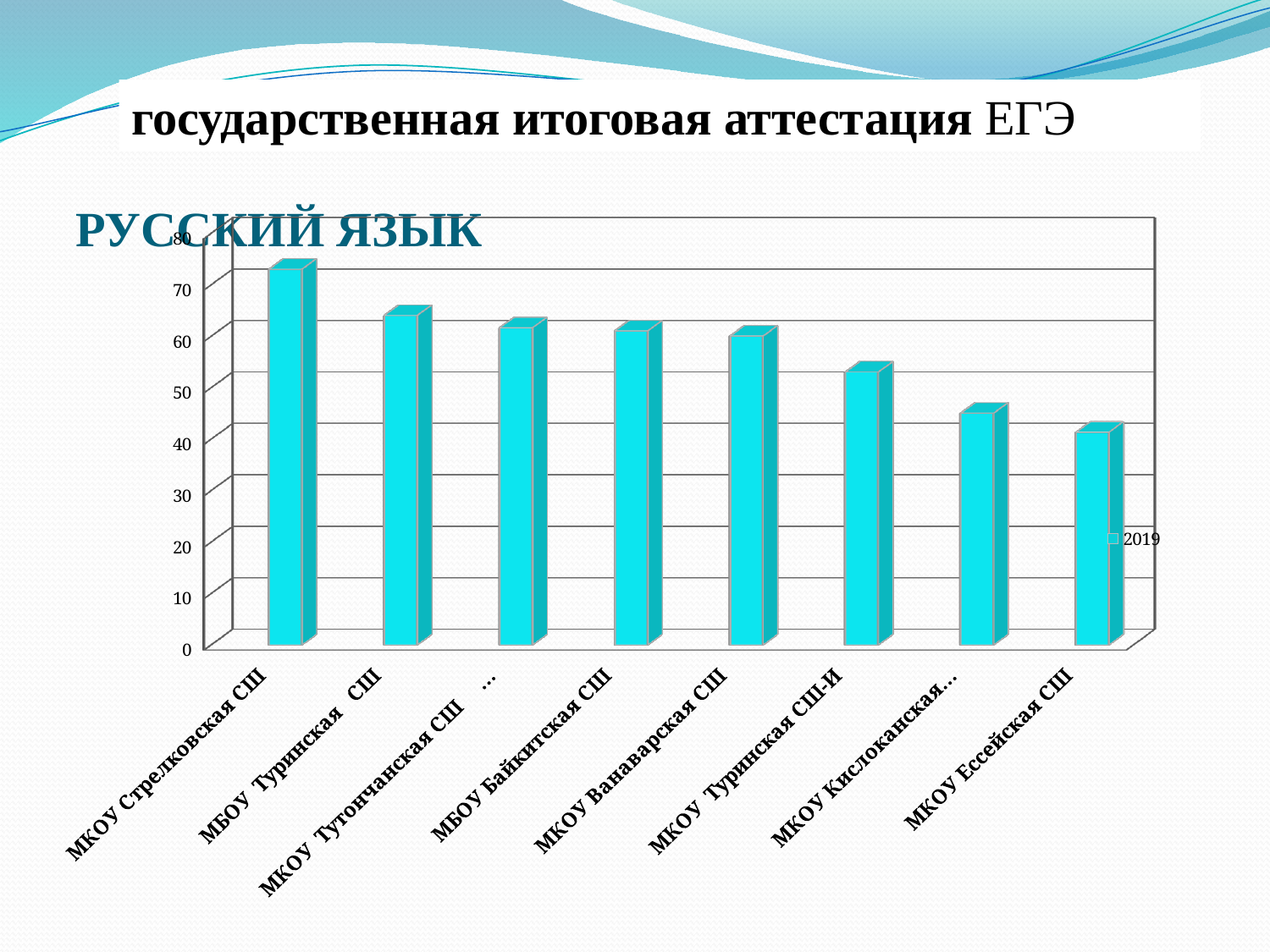
How many schools (categories) are plotted on the chart? 8 What kind of chart is shown on the slide? bar chart Is the value for МКОУ Кислоканская greater or less than 50? less How many series does the legend list? 1 Is the value for МКОУ Стрелковская СШ greater or less than 70? greater Which school has the highest bar on the chart? МКОУ Стрелковская СШ Is the value for МКОУ Ессейская СШ greater or less than 50? less Do the bar values rise or fall from left to right along the x axis? fall What year is shown in the chart legend? 2019 Which school has the lowest bar on the chart? МКОУ Ессейская СШ Which is larger, the value for МКОУ Ванаварская СШ or the value for МКОУ Туринская СШ-И? МКОУ Ванаварская СШ